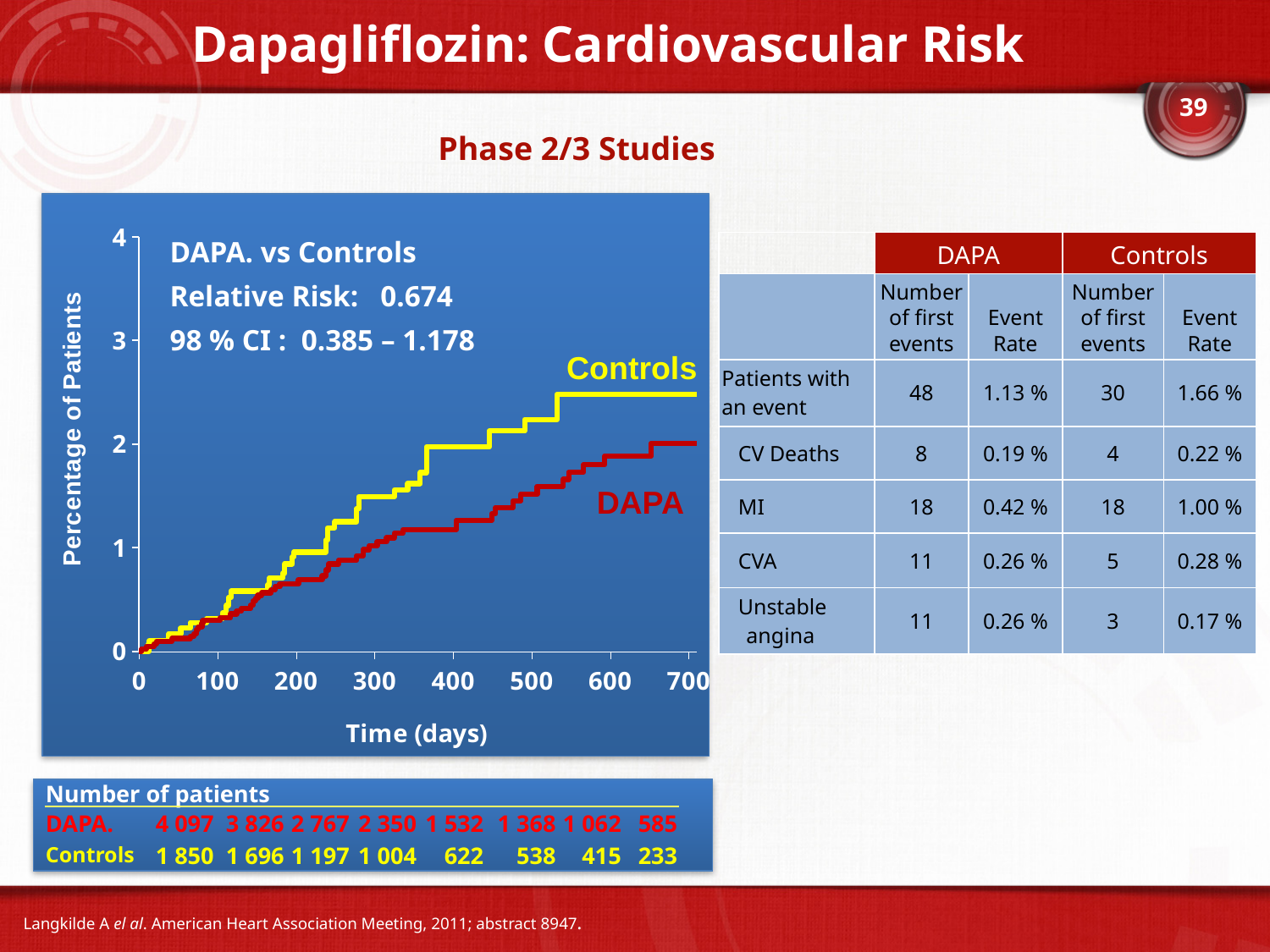
Is the value for Controls at 700 days greater or less than 2? greater Is the value for DAPA at 700 days greater or less than 3? less Is the value for Controls at 300 days greater or less than 1? greater Do the Controls and DAPA lines rise or fall as time increases? rise What is the label of the x axis of the line chart? Time (days) What is the label of the y axis of the line chart? Percentage of Patients What relative risk for DAPA vs Controls is printed on the chart? 0.674 According to the number of patients row below the chart, how many DAPA patients were there at day 0? 4 097 At 700 days, which line is higher, Controls or DAPA? Controls How many series are plotted in the line chart? 2 Which colour is used for the Controls line in the chart? yellow What kind of chart is shown on the left of the slide? line chart